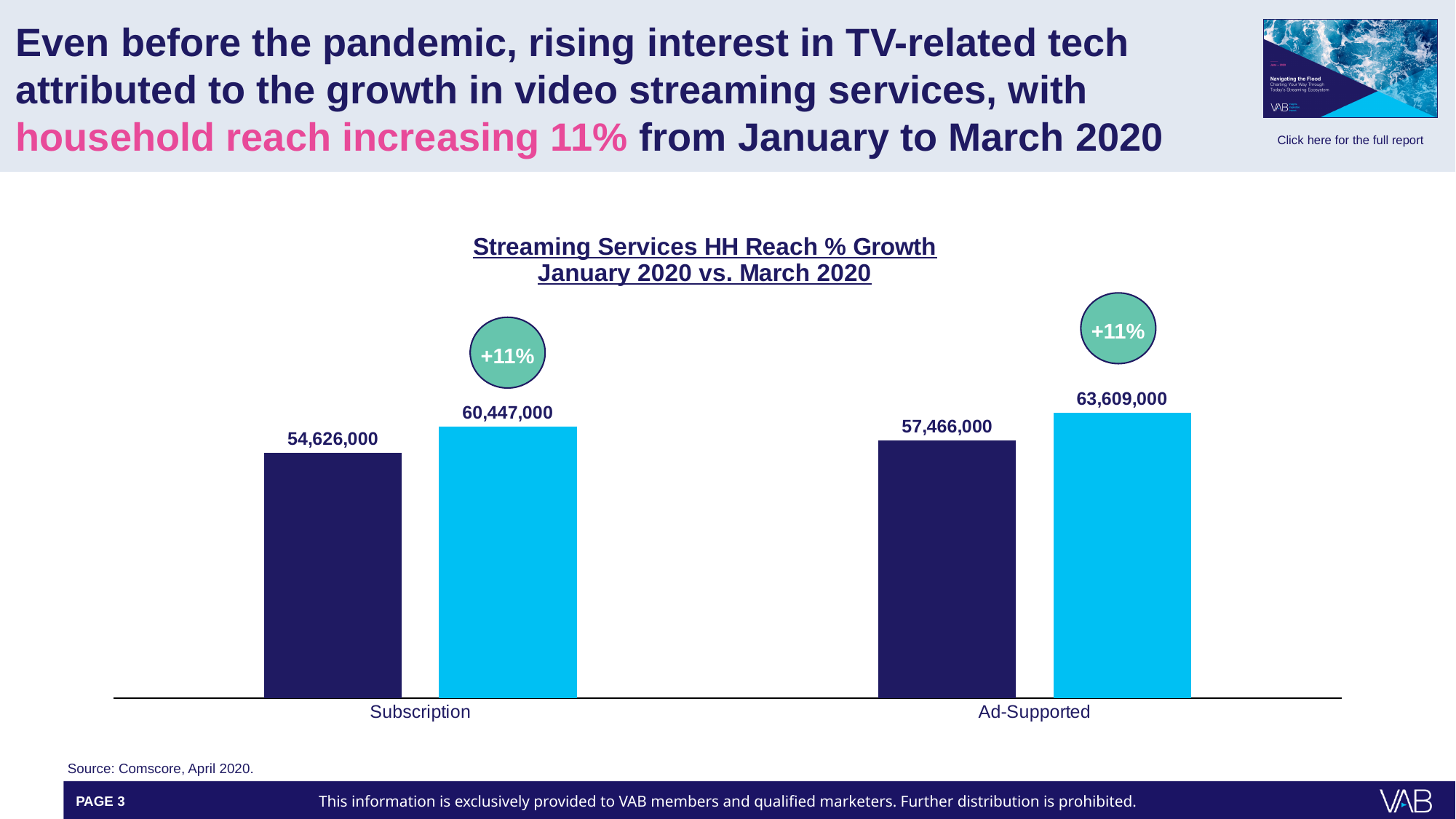
Which bar on the chart has the lowest value? Subscription dark navy bar (54,626,000) What is the difference between the light blue and dark navy bars for Ad-Supported? 6,143,000 What percentage growth is shown in the circle above each category? +11% What is the value of the dark navy (left) bar for Subscription? 54,626,000 What kind of chart is shown on the slide? Bar chart How many categories are shown on the x axis of the chart? 2 What is the difference between the light blue and dark navy bars for Subscription? 5,821,000 Which is larger: the light blue bar for Subscription or the light blue bar for Ad-Supported? Ad-Supported Which bar on the chart has the highest value? Ad-Supported light blue bar (63,609,000) What is the value of the light blue (right) bar for Ad-Supported? 63,609,000 What is the value of the light blue (right) bar for Subscription? 60,447,000 What is the value of the dark navy (left) bar for Ad-Supported? 57,466,000